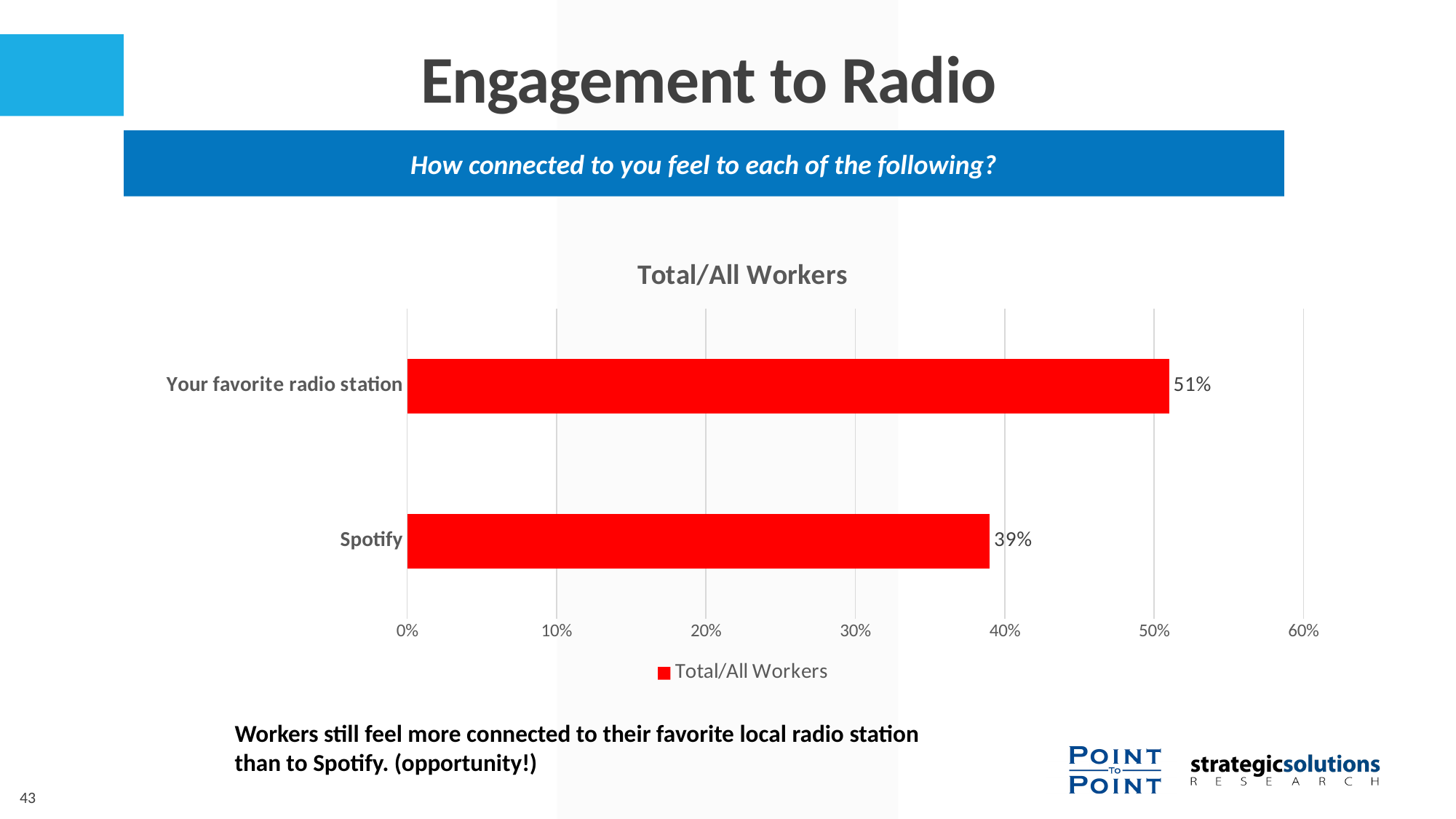
What is the title of the chart? Total/All Workers How many series does the legend list? 1 Is the value for Spotify greater or less than 40%? less What is the value for Your favorite radio station? 51% What is the value for Spotify? 39% Which is larger, the value for Spotify or the value for Your favorite radio station? Your favorite radio station Which category has the highest value? Your favorite radio station Which category has the lowest value? Spotify How many categories are shown in the chart? 2 What kind of chart is shown on the slide? Bar chart Is the value for Your favorite radio station greater or less than 50%? greater What is the difference between the values for Your favorite radio station and Spotify? 12%